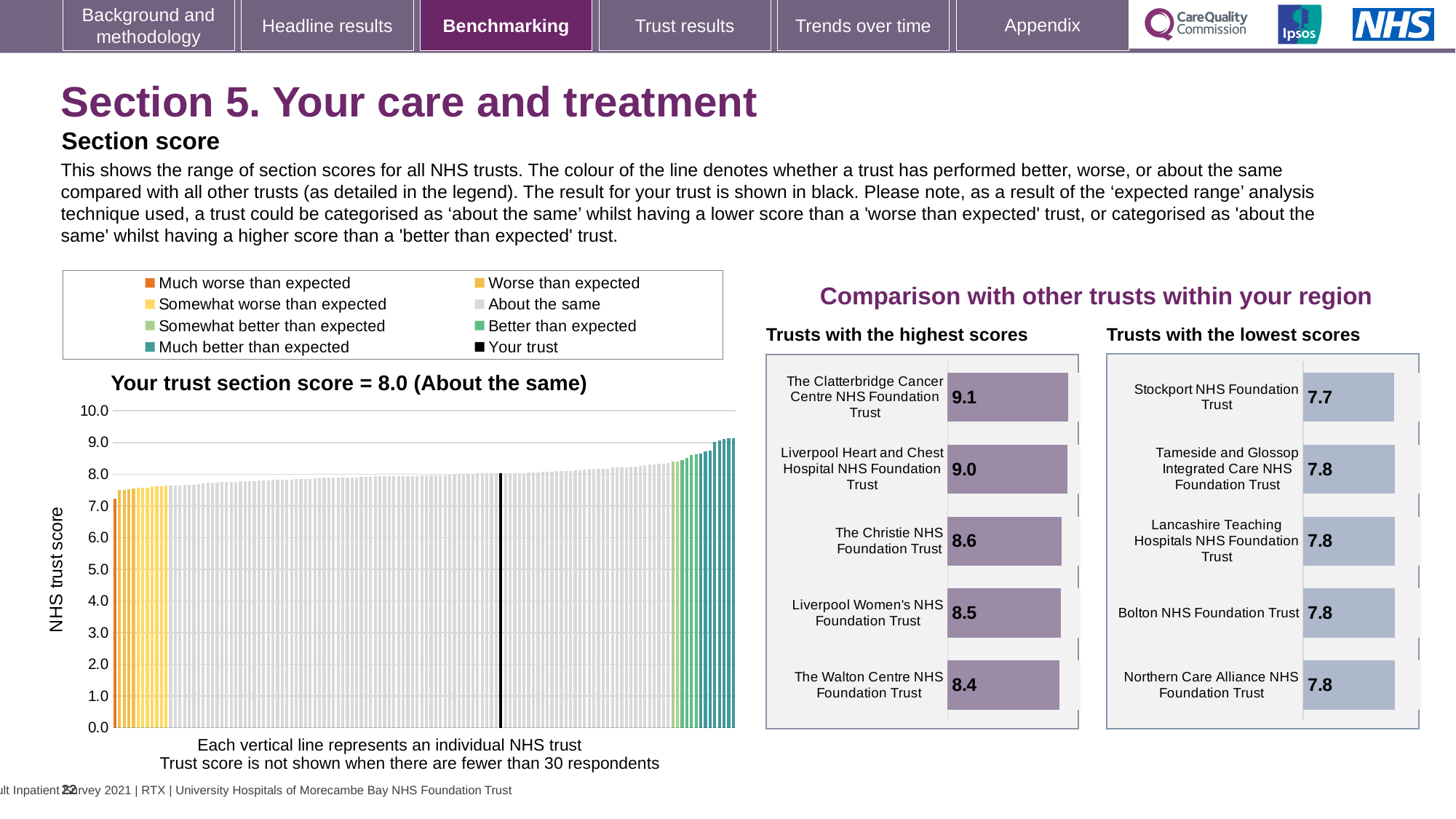
According to the title of the main chart on the left, what is your trust's section score? 8.0 In the 'Trusts with the highest scores' chart, what is the score for The Walton Centre NHS Foundation Trust? 8.4 In the 'Trusts with the highest scores' chart, what is the difference between the scores of The Clatterbridge Cancer Centre NHS Foundation Trust and The Walton Centre NHS Foundation Trust? 0.7 In the 'Trusts with the highest scores' chart, which has the higher score: The Christie NHS Foundation Trust or Liverpool Women's NHS Foundation Trust? The Christie NHS Foundation Trust How many entries does the legend above the main chart on the left list? 8 In the 'Trusts with the highest scores' chart, which trust has the highest score? The Clatterbridge Cancer Centre NHS Foundation Trust In the 'Trusts with the lowest scores' chart, what is the score for Bolton NHS Foundation Trust? 7.8 In the 'Trusts with the highest scores' chart, what is the score for The Clatterbridge Cancer Centre NHS Foundation Trust? 9.1 In the 'Trusts with the lowest scores' chart, which trust has the lowest score? Stockport NHS Foundation Trust How many trusts are shown in the 'Trusts with the lowest scores' chart? 5 In the main chart on the left, do the trust scores rise or fall from left to right? Rise What kind of chart is the main chart on the left showing the range of section scores? Bar chart